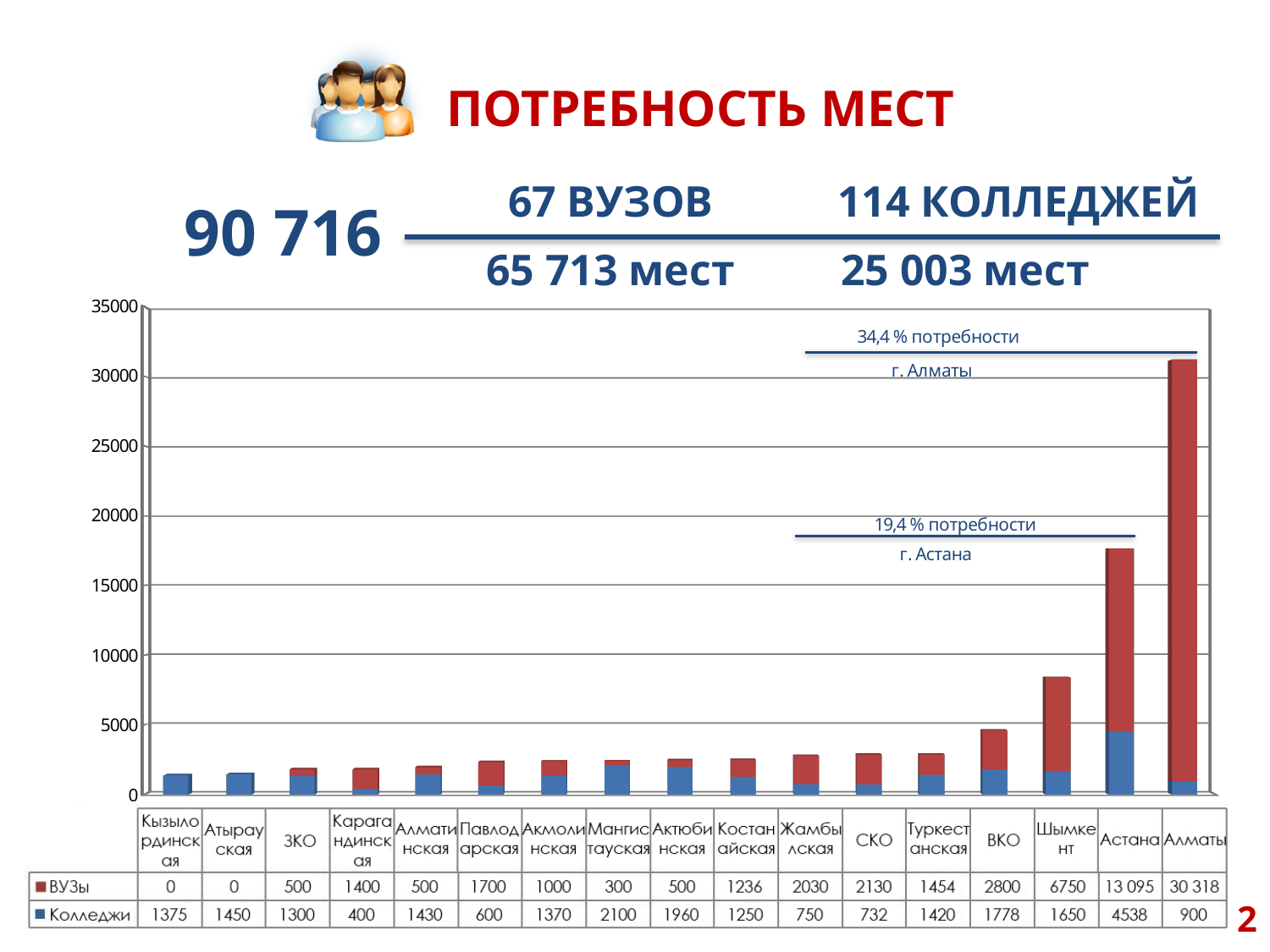
Which category has the lowest value for Колледжи? Карагандинская What is the total of the stacked bar for Шымкент? 8400 What is the value for ВУЗы in Жамбылская? 2030 How many series does the legend list? 2 Which is larger, the Колледжи value for Мангистауская or for Актюбинская? Мангистауская Which category has the highest value for ВУЗы? Алматы How many categories are shown on the x axis? 17 What is the difference between the ВУЗы values for Астана and Шымкент? 6345 Is the total of the stacked bar for Алматы greater or less than 30000? greater Which category has the highest value for Колледжи? Астана What is the value for ВУЗы in Алматы? 30 318 What is the value for Колледжи in Астана? 4538